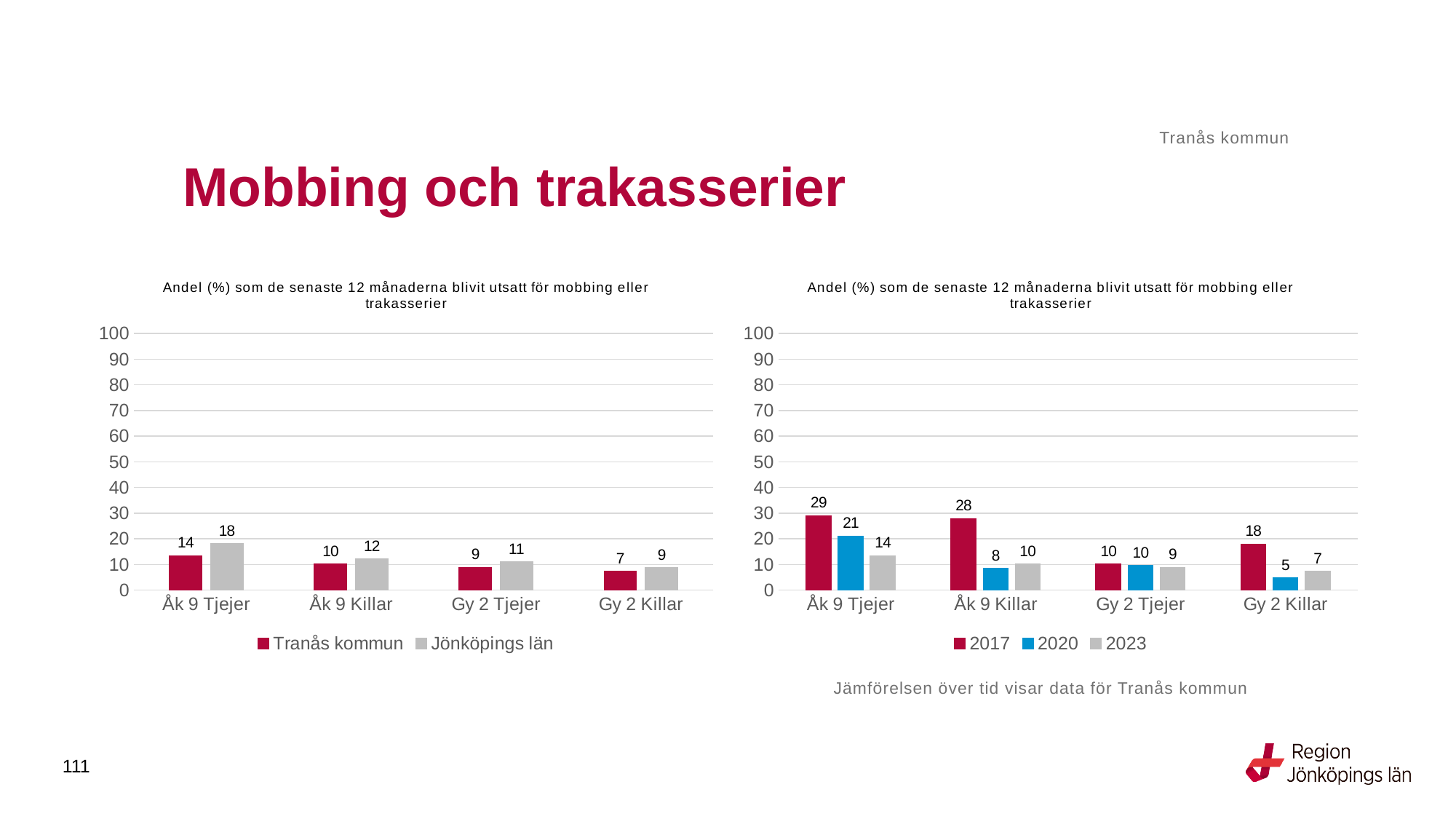
In the right chart, what is the value for 2023 for Gy 2 Killar? 7 In the left chart, what is the value for Jönköpings län for Gy 2 Killar? 9 In the right chart, which is larger for Åk 9 Killar: the 2017 value or the 2023 value? 2017 In the left chart, which category has the highest value for Jönköpings län? Åk 9 Tjejer What kind of chart is the right chart? Bar chart In the left chart, how many series does the legend list? 2 In the left chart, what is the difference between Jönköpings län and Tranås kommun for Åk 9 Tjejer? 4 In the right chart, what is the difference between the 2017 and 2023 values for Åk 9 Killar? 18 In the left chart, what is the value for Tranås kommun for Åk 9 Tjejer? 14 In the right chart, which category has the lowest value for 2020? Gy 2 Killar In the right chart, how does the value for Gy 2 Tjejer change from 2017 to 2023? It falls from 10 to 9 In the right chart, what is the value for 2020 for Åk 9 Tjejer? 21